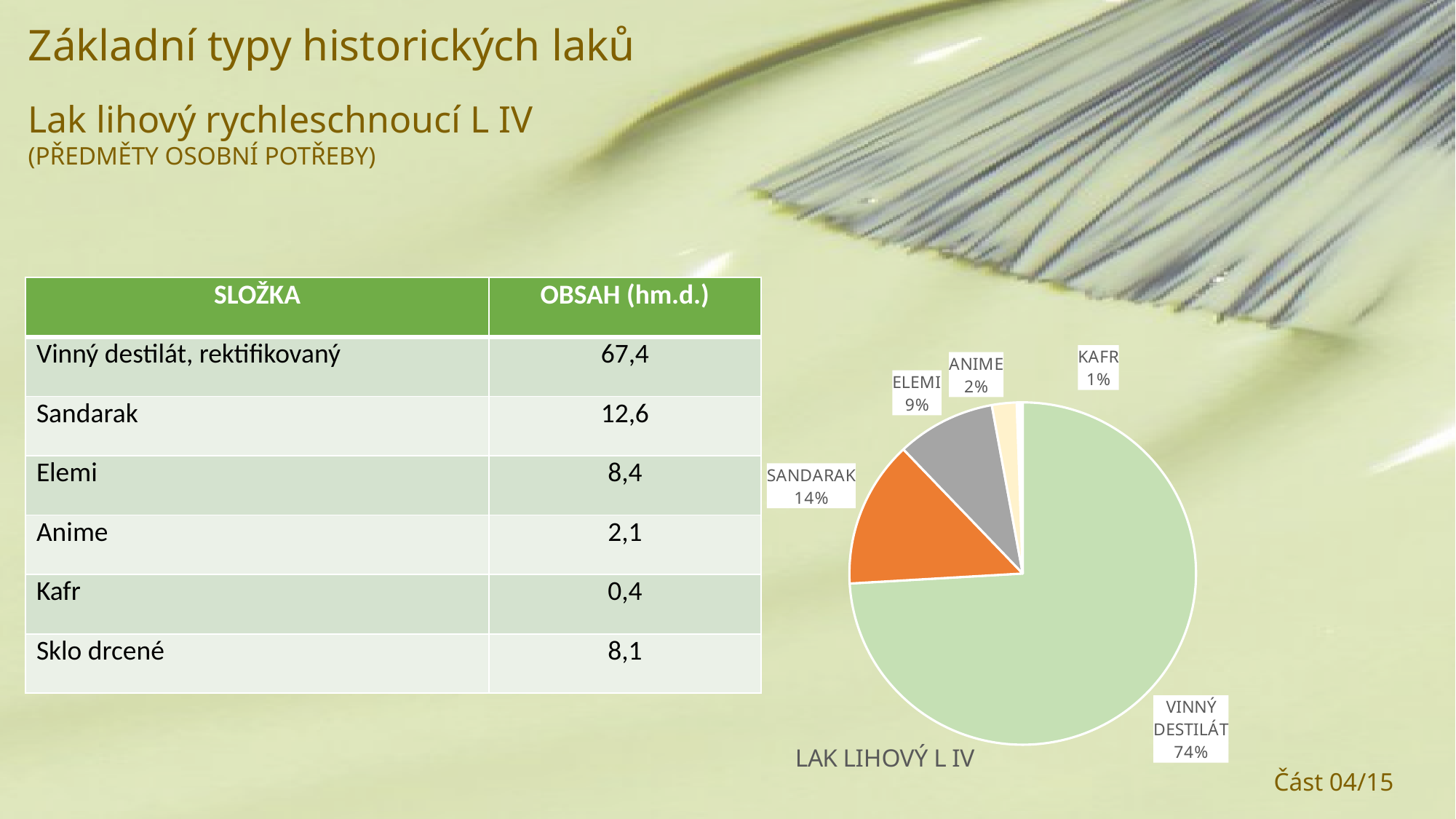
How many slices does the pie chart have? 5 Which slice of the pie chart is the largest? VINNÝ DESTILÁT What share of the pie chart does ANIME have? 2% In the pie chart, which is larger: SANDARAK or ELEMI? SANDARAK In the pie chart, what is the difference in percentage points between SANDARAK and ELEMI? 5% What is the title of the pie chart? LAK LIHOVÝ L IV What share of the pie chart does KAFR have? 1% What kind of chart is shown on the slide? pie chart What share of the pie chart does ELEMI have? 9% Which slice of the pie chart is the smallest? KAFR